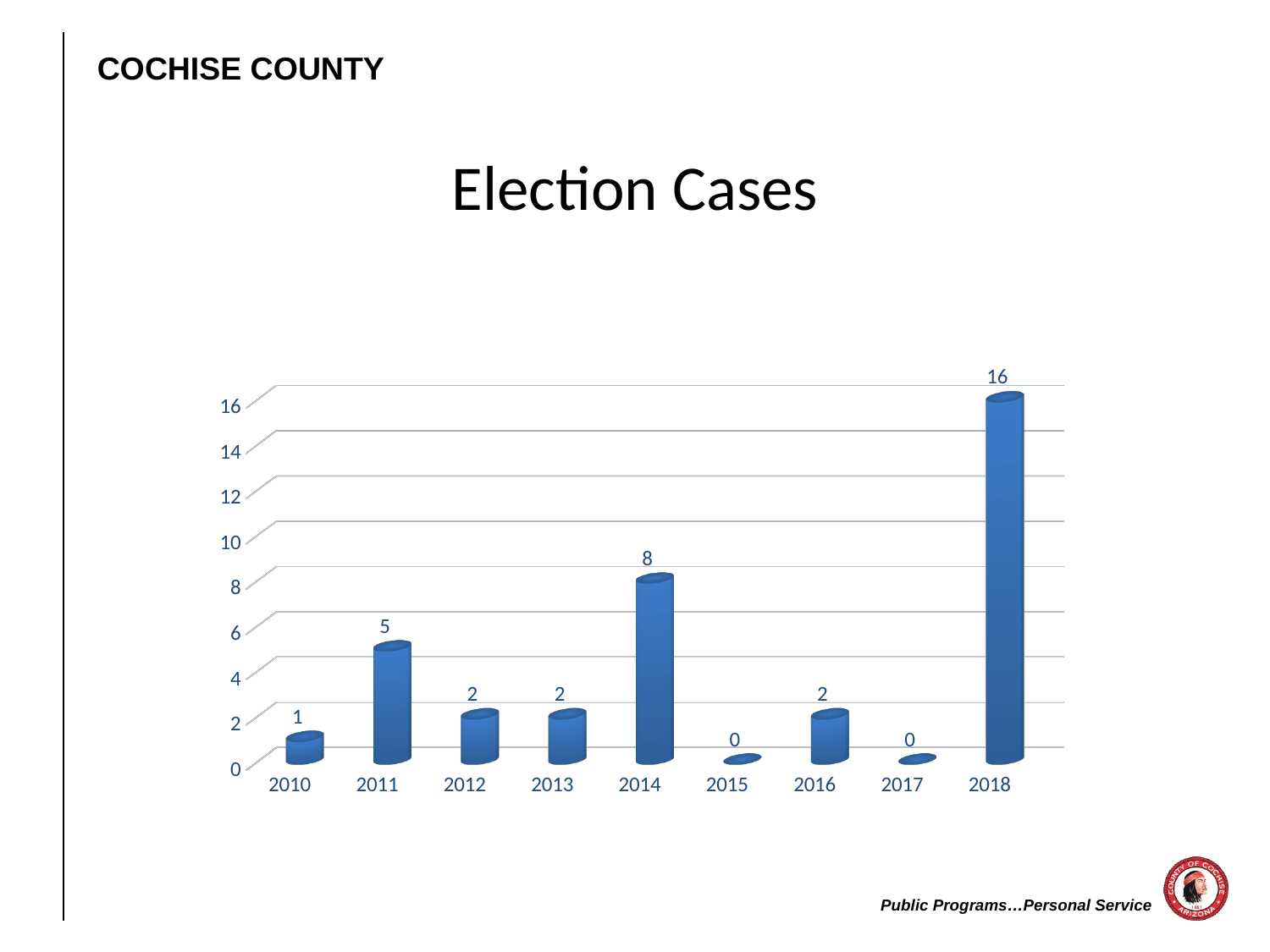
How many years are shown on the x axis of the chart? 9 What is the difference in election cases between 2011 and 2012? 3 What is the difference in election cases between 2018 and 2014? 8 How many years show 0 election cases? 2 What is the number of election cases in 2010? 1 What is the number of election cases in 2018? 16 What is the number of election cases in 2014? 8 Which year has the highest number of election cases? 2018 Which year has more election cases, 2011 or 2016? 2011 What kind of chart is shown on the slide? Bar chart What is the title of the chart? Election Cases What is the number of election cases in 2011? 5